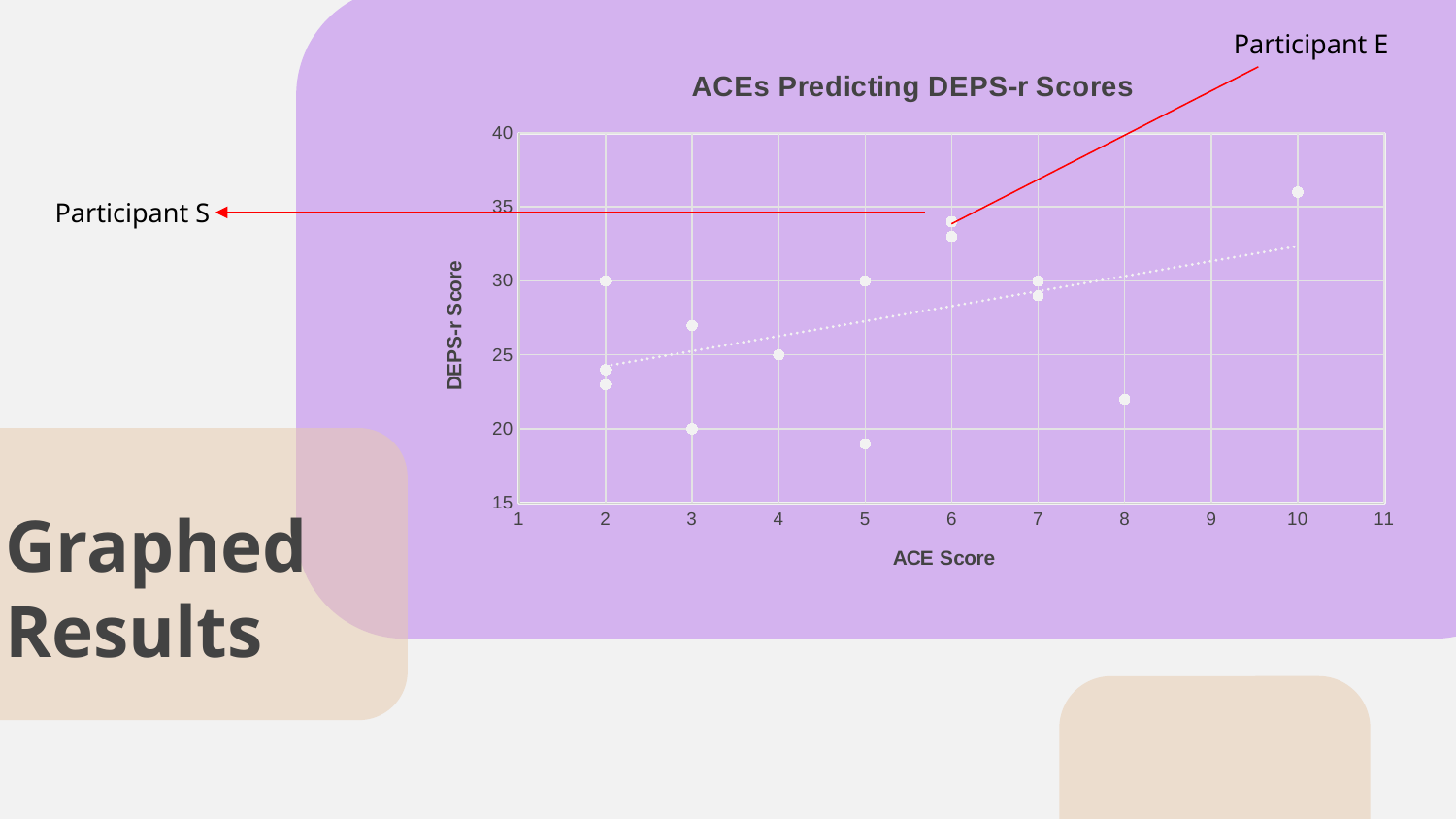
Is the DEPS-r Score for the point at ACE Score 10 greater or less than 35? greater At which ACE Score is the highest DEPS-r Score plotted? 10 What is the title of the chart? ACEs Predicting DEPS-r Scores What DEPS-r Score is plotted for the participant with an ACE Score of 4? 25 Does the dotted trend line rise or fall as ACE Score increases? rises What kind of chart is shown on the slide? Scatter plot Is the DEPS-r Score for the point at ACE Score 8 greater or less than 25? less How many data points are plotted on the chart? 14 What ACE Score does Participant E have? 6 Is the DEPS-r Score for Participant S greater or less than 30? greater What is the label on the x axis of the chart? ACE Score Which has the larger DEPS-r Score: the highest point at ACE Score 2 or the point at ACE Score 8? The point at ACE Score 2